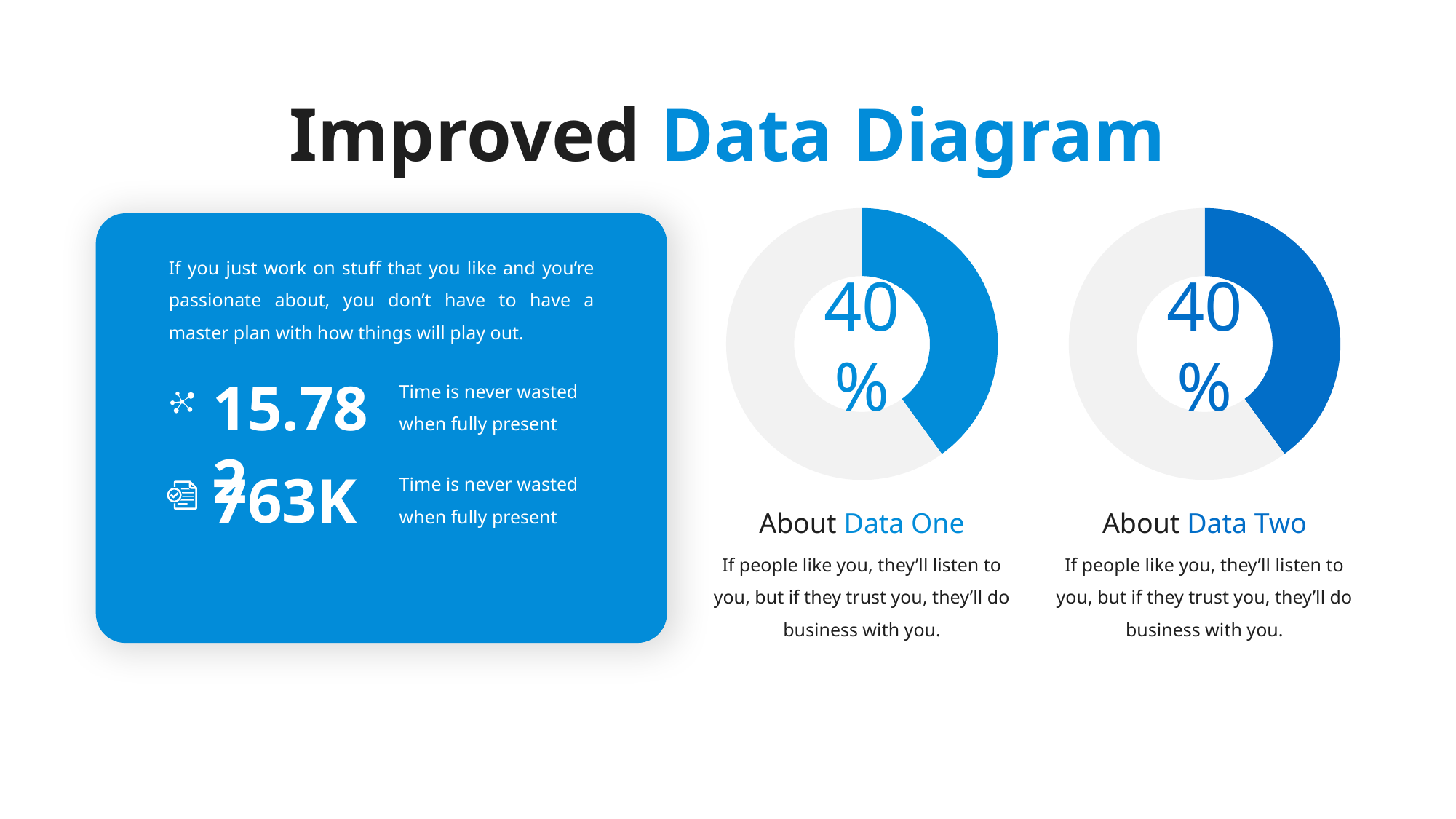
Is the value shown in the 'About Data One' donut chart greater or less than 50%? less Is the value in the 'About Data One' chart larger than, smaller than, or equal to the value in the 'About Data Two' chart? equal Is the value shown in the 'About Data Two' donut chart greater or less than 50%? less How many donut charts are shown on the slide? 2 In the 'About Data One' donut chart, what share of the ring is filled in blue? 40% What kind of chart is used for 'About Data One'? Donut chart What is the title of the slide containing the two donut charts? Improved Data Diagram In the 'About Data Two' donut chart, what share of the ring is left grey (unfilled)? 60% What kind of chart is used for 'About Data Two'? Donut chart What percentage is shown in the centre of the 'About Data Two' donut chart? 40% What is the difference between the percentages shown in the 'About Data One' and 'About Data Two' charts? 0% What percentage is shown in the centre of the 'About Data One' donut chart? 40%